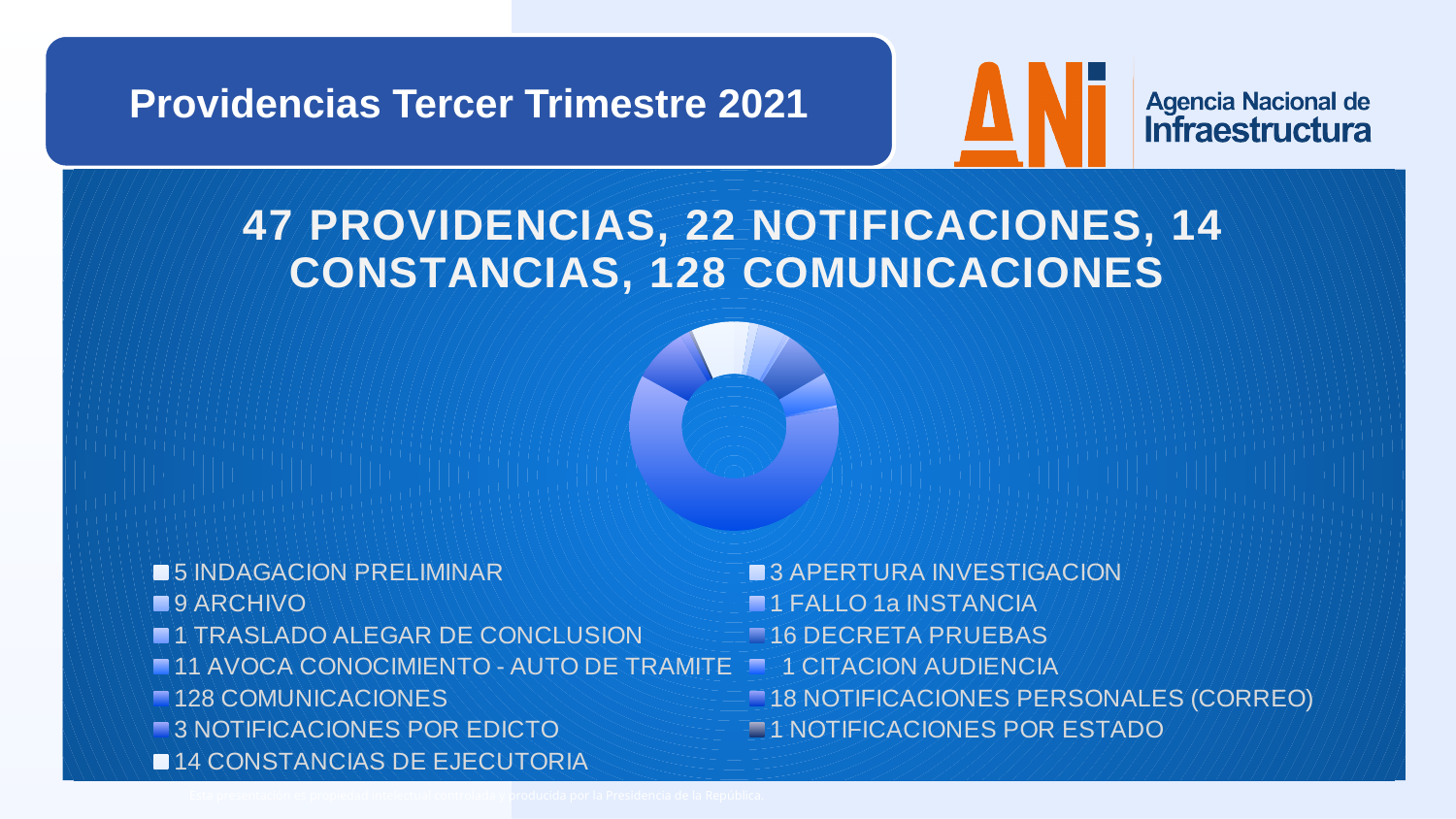
What is the value for CONSTANCIAS DE EJECUTORIA? 14 What is the difference between the values for COMUNICACIONES and NOTIFICACIONES PERSONALES (CORREO)? 110 What is the title shown in the box at the top left of the slide? Providencias Tercer Trimestre 2021 What is the value for COMUNICACIONES? 128 What is the value for DECRETA PRUEBAS? 16 What is the value for AVOCA CONOCIMIENTO - AUTO DE TRAMITE? 11 Which category has the highest value in the chart? COMUNICACIONES Which is larger, the value for DECRETA PRUEBAS or the value for ARCHIVO? DECRETA PRUEBAS What is the difference between the values for ARCHIVO and INDAGACION PRELIMINAR? 4 What is the value for NOTIFICACIONES PERSONALES (CORREO)? 18 What kind of chart is shown on the slide? Doughnut (pie) chart How many categories does the chart's legend list? 13